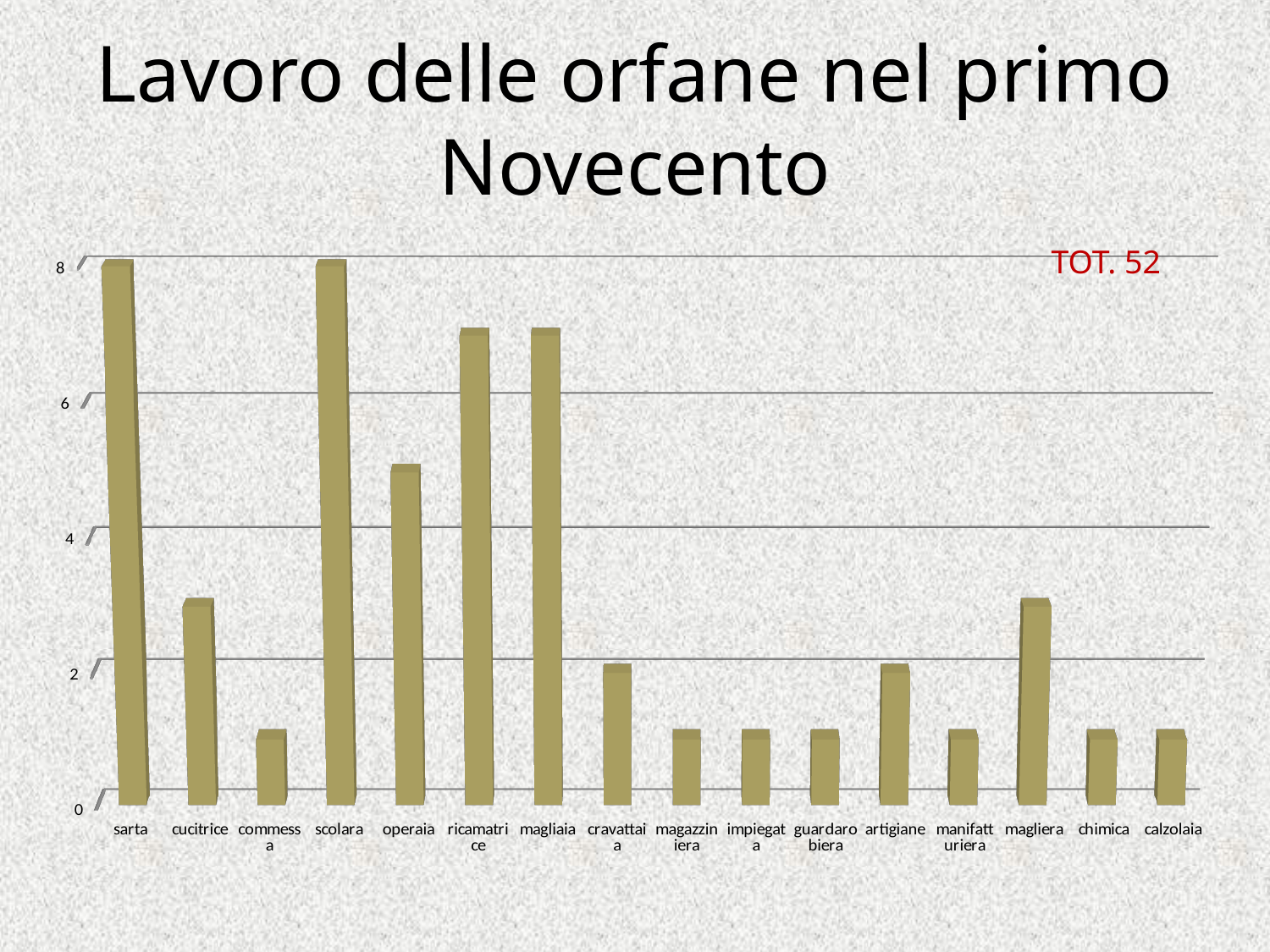
What is the value for cravattaia? 2 Which is larger, the value for magliaia or the value for magliera? magliaia Which is larger, the value for operaia or the value for cucitrice? operaia What is the value for artigiane? 2 How many categories are shown on the x axis? 16 Is the value for chimica greater or less than 2? less What kind of chart is shown on the slide? bar chart Is the value for operaia greater or less than 4? greater Is the value for cucitrice greater or less than 4? less What is the value for scolara? 8 What is the value for sarta? 8